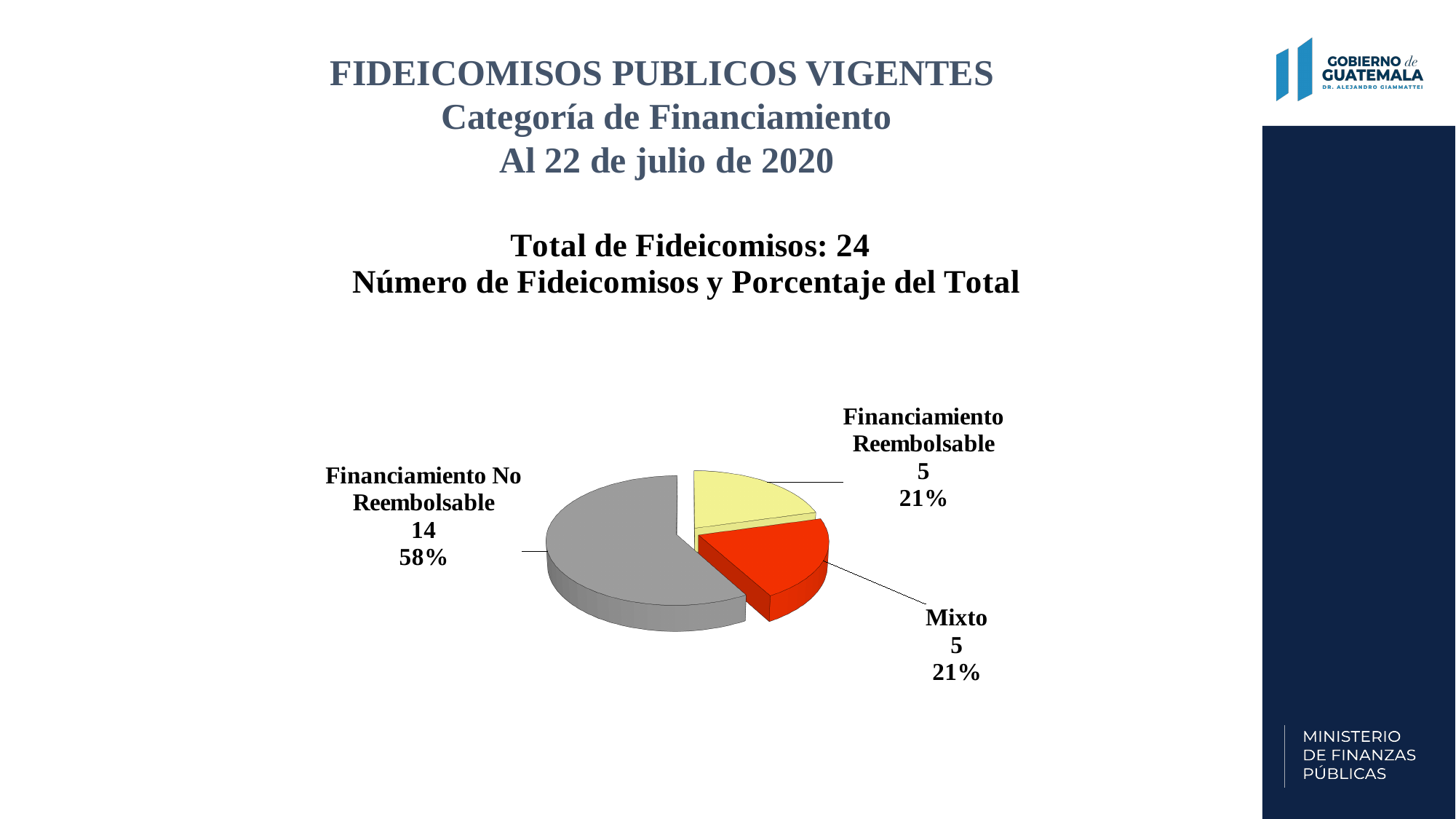
How many fideicomisos are in the Financiamiento No Reembolsable category? 14 What percentage of the total does Financiamiento No Reembolsable represent? 58% How many categories does the pie chart show? 3 What is the difference in the number of fideicomisos between Financiamiento No Reembolsable and Mixto? 9 Which category has the largest number of fideicomisos? Financiamiento No Reembolsable What percentage of the total does Financiamiento Reembolsable represent? 21% Which is larger: the number of fideicomisos for Financiamiento No Reembolsable or for Financiamiento Reembolsable? Financiamiento No Reembolsable What date is given in the slide title for the data? 22 de julio de 2020 What colour is the Mixto slice of the pie chart? Red How many fideicomisos are in the Mixto category? 5 What is the total number of fideicomisos stated on the slide? 24 What kind of chart is shown on the slide? Pie chart